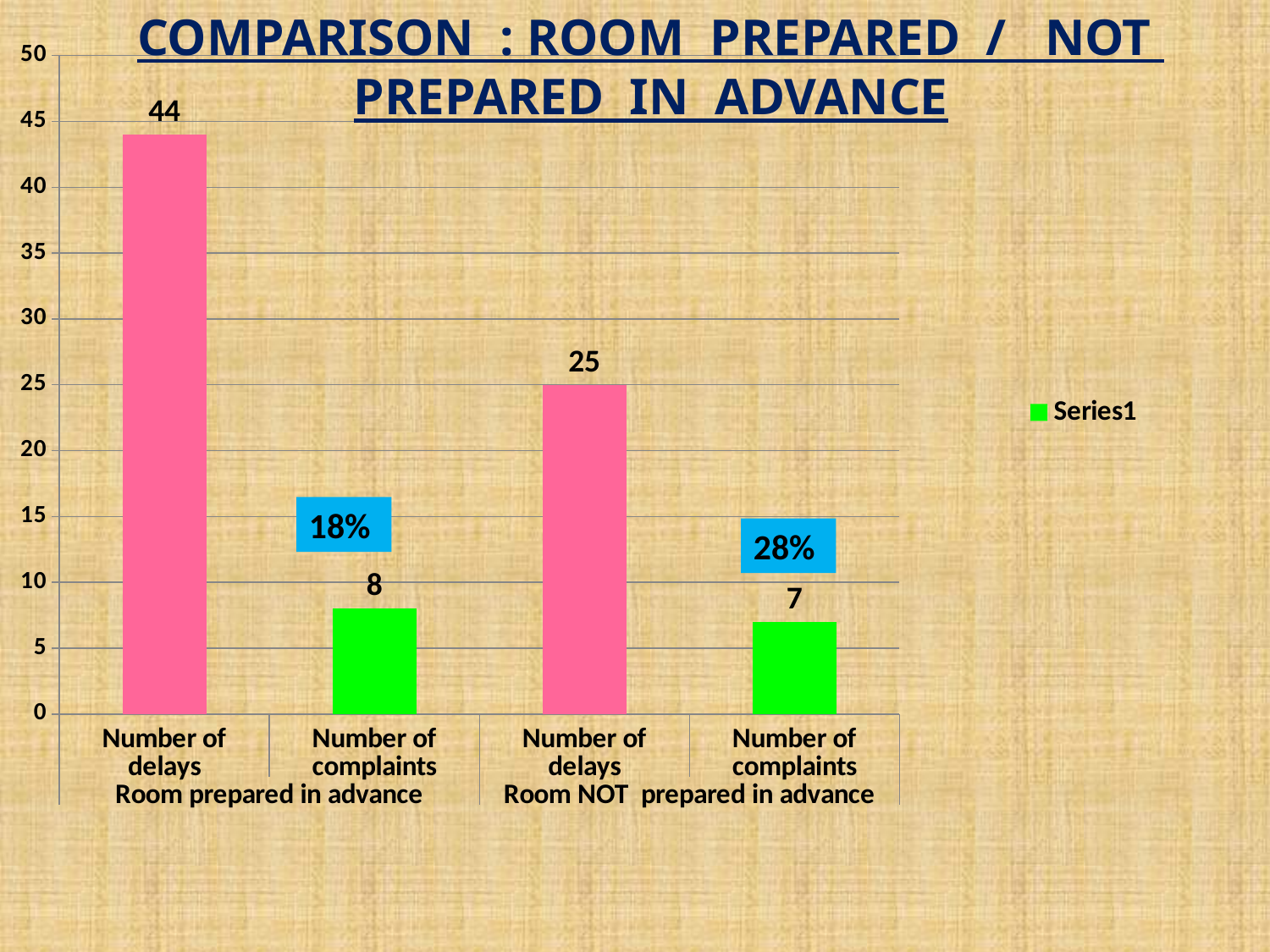
How many bars are plotted in the chart? 4 What is the number of complaints for rooms NOT prepared in advance? 7 Which bar has the lowest value? Number of complaints, Room NOT prepared in advance What is the title of the chart? COMPARISON : ROOM PREPARED / NOT PREPARED IN ADVANCE What is the difference between the number of delays for rooms prepared in advance and rooms NOT prepared in advance? 19 What is the number of delays for rooms prepared in advance? 44 What is the number of delays for rooms NOT prepared in advance? 25 Which bar has the highest value? Number of delays, Room prepared in advance What is the number of complaints for rooms prepared in advance? 8 What percentage label is shown above the complaints bar for rooms NOT prepared in advance? 28% Which is larger: the number of complaints for rooms prepared in advance or for rooms NOT prepared in advance? Room prepared in advance What kind of chart is shown on the slide? Bar chart